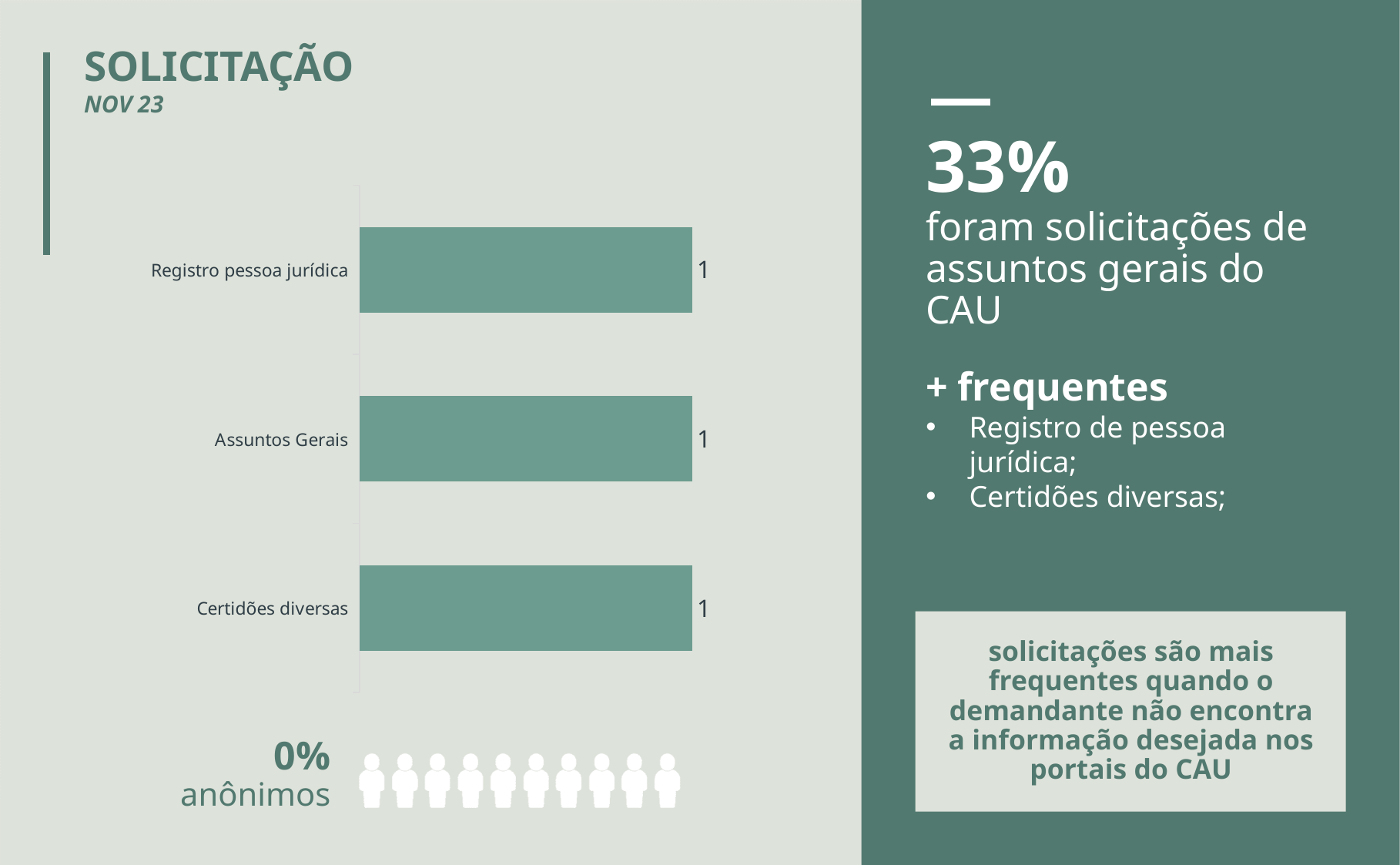
What is the value for Registro pessoa jurídica? 1 Which category is listed at the top of the bar chart? Registro pessoa jurídica What is the value for Certidões diversas? 1 How many categories does the bar chart show? 3 What is the difference between the values for Registro pessoa jurídica and Certidões diversas? 0 Which category is listed at the bottom of the bar chart? Certidões diversas What is the value for Assuntos Gerais? 1 Do all three bars in the chart have the same value? Yes What kind of chart is shown on the slide? bar chart What is the difference between the values for Assuntos Gerais and Certidões diversas? 0